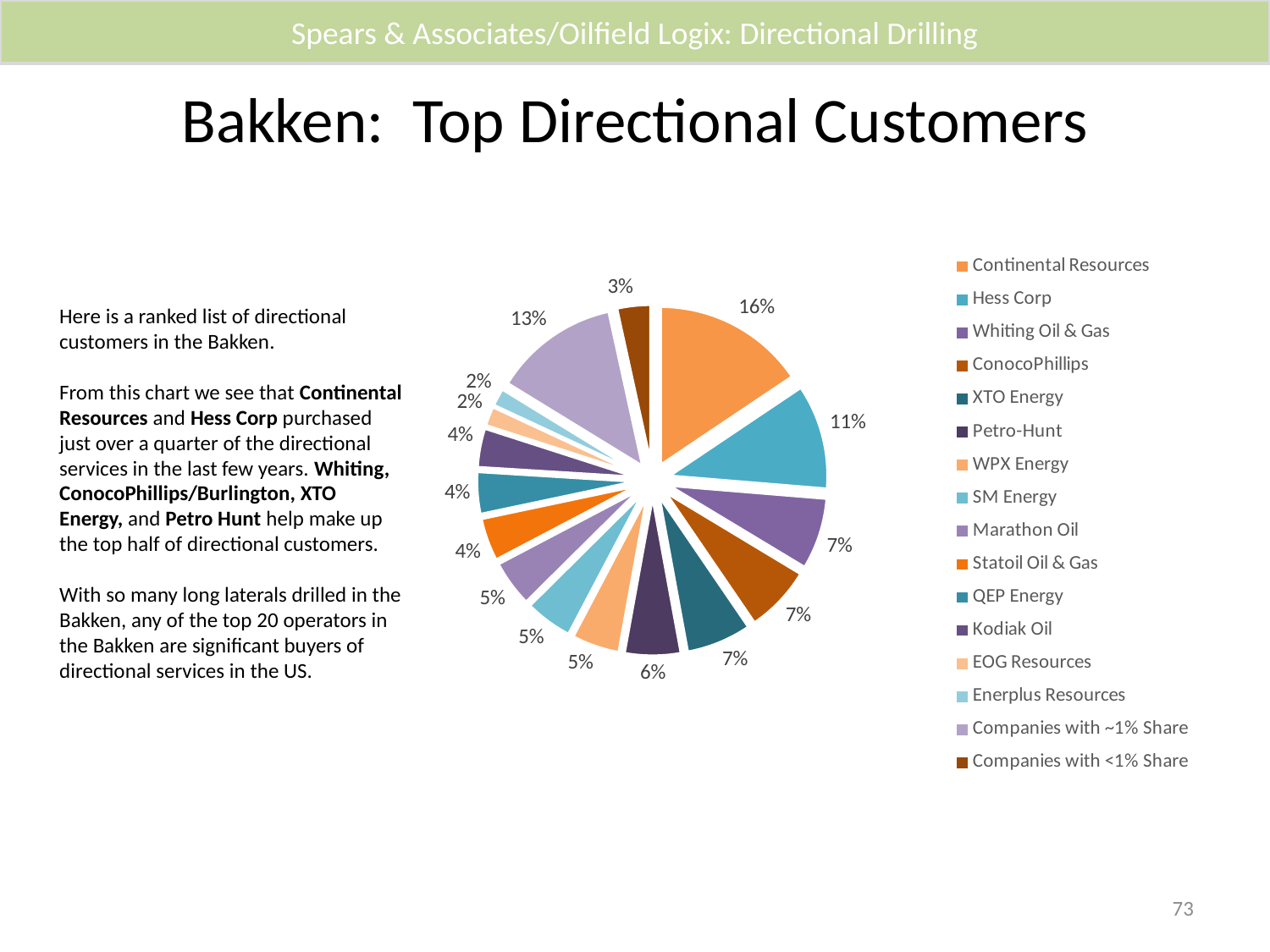
What share of the pie is labelled for Companies with <1% Share? 3% What is the combined share of Continental Resources and Hess Corp? 27% Which has the larger share, Hess Corp or Petro-Hunt? Hess Corp What share of the pie is labelled for Companies with ~1% Share? 13% What share of the pie does Petro-Hunt hold? 6% What share of the pie does Continental Resources hold? 16% Which named company has the largest slice of the pie? Continental Resources How many entries does the legend of the pie chart list? 16 What kind of chart is shown on the slide? pie chart What share of the pie does Hess Corp hold? 11% What is the difference in share between Continental Resources and Hess Corp? 5% What is the title of the slide containing the pie chart? Bakken: Top Directional Customers